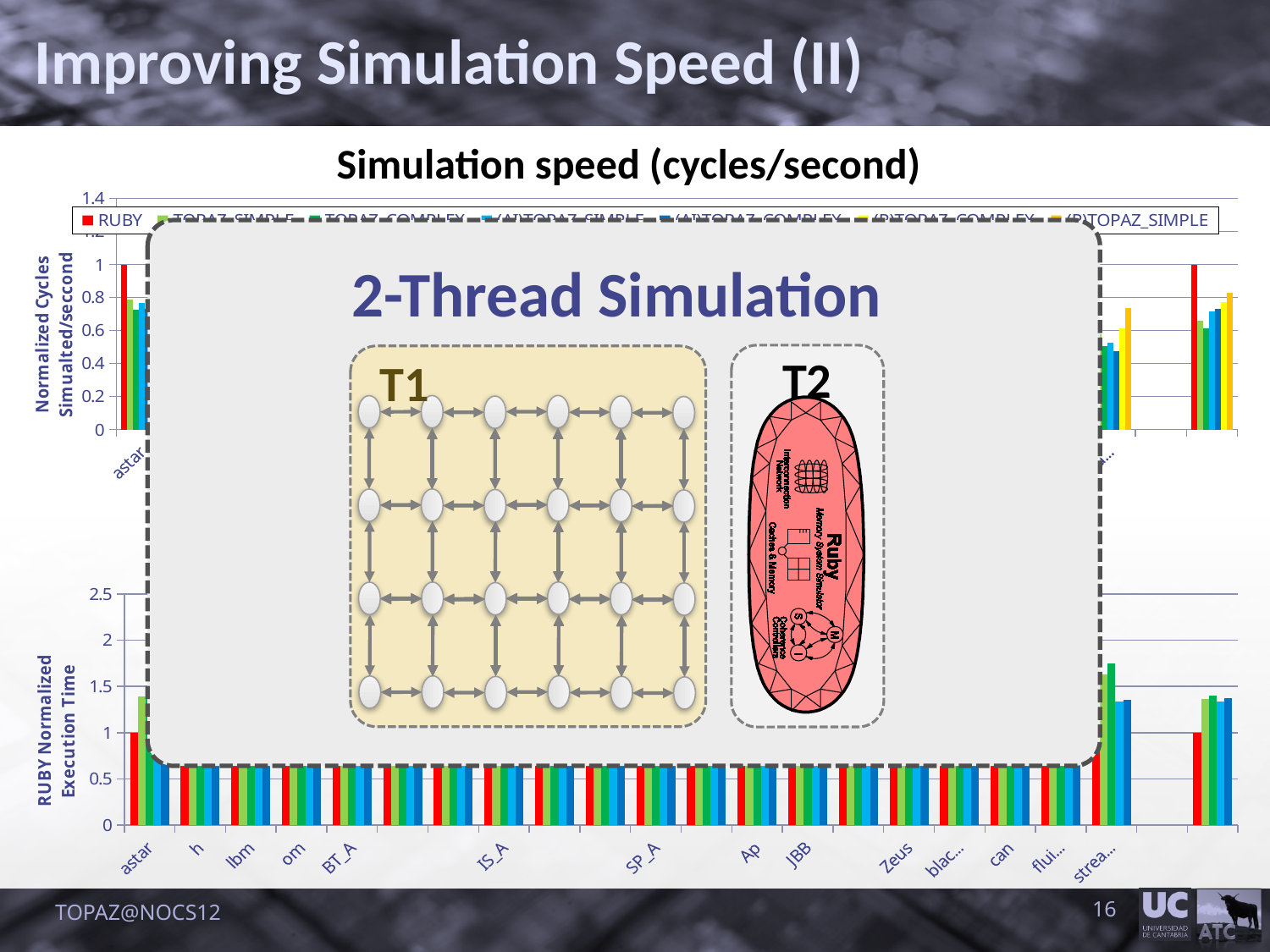
In the bottom chart, is the value of the green bar for astar greater or less than 1? greater What is the y-axis label of the bottom chart? RUBY Normalized Execution Time In the bottom chart, is the value of the green bar for strea... greater or less than 1.5? greater In the bottom chart, what is the value of the RUBY bar for astar? 1 What is the title of the top chart on the slide? Simulation speed (cycles/second) What is the highest tick value shown on the y-axis of the bottom chart? 2.5 In the top chart 'Simulation speed (cycles/second)', is the value of the green bar for astar greater or less than 0.6? greater In the top chart 'Simulation speed (cycles/second)', which is larger for astar: the RUBY bar or the green bar? the RUBY bar What kind of chart is the top chart titled 'Simulation speed (cycles/second)'? bar chart In the bottom chart, which is larger for astar: the RUBY bar or the green bar? the green bar In the top chart 'Simulation speed (cycles/second)', what is the value of the RUBY bar for astar? 1